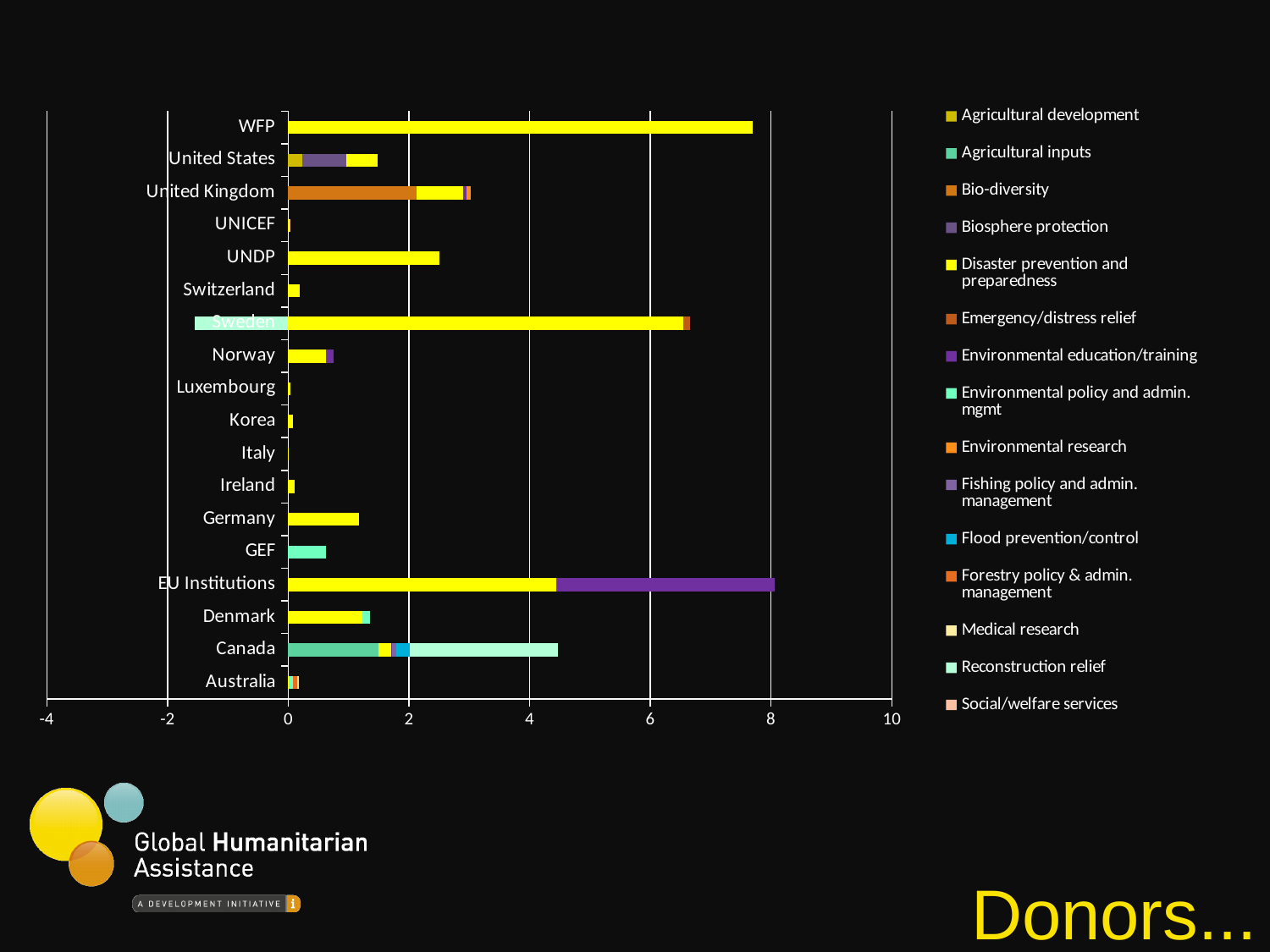
Is the total value of the bar for Canada greater or less than 4? greater Is the total value of the bar for WFP greater or less than 6? greater What kind of chart is shown on the slide? bar chart Is the total value of the bar for EU Institutions greater or less than 6? greater Which donor has a bar segment extending to the left of 0 (a negative value)? Sweden How many series does the chart's legend list? 15 Which bar is longer, WFP or UNDP? WFP How many donor categories are listed on the vertical axis of the chart? 18 Which colour does the legend use for 'Disaster prevention and preparedness'? yellow Which bar is longer, Canada or Germany? Canada